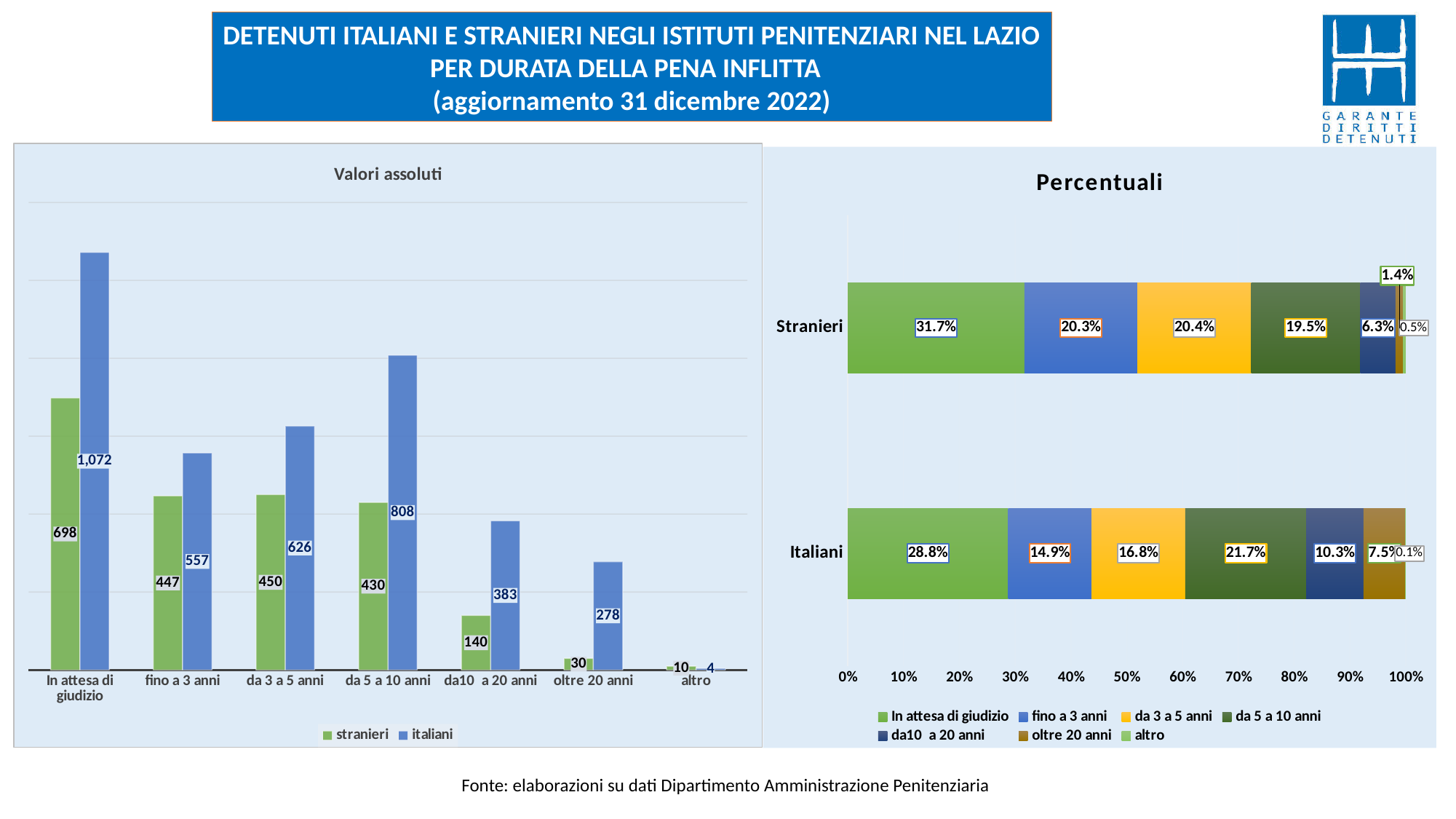
In the 'Percentuali' chart, what is the share of 'da 5 a 10 anni' for Italiani? 21.7% In the 'Valori assoluti' chart, which category has the highest value for italiani? In attesa di giudizio In the 'Valori assoluti' chart, what is the value for italiani in the 'In attesa di giudizio' category? 1,072 In the 'Valori assoluti' chart, which is larger in the 'da 3 a 5 anni' category: stranieri or italiani? italiani How many series does the legend of the 'Valori assoluti' chart list? 2 In the 'Valori assoluti' chart, what is the difference between italiani and stranieri in the 'oltre 20 anni' category? 248 In the 'Percentuali' chart, which is larger for 'oltre 20 anni': Stranieri or Italiani? Italiani What kind of chart is the 'Percentuali' chart? Stacked bar chart In the 'Valori assoluti' chart, which category has the lowest value for stranieri? altro In the 'Percentuali' chart, what is the share of 'In attesa di giudizio' for Stranieri? 31.7% How many categories are shown on the x axis of the 'Valori assoluti' chart? 7 In the 'Valori assoluti' chart, what is the value for stranieri in the 'da 5 a 10 anni' category? 430